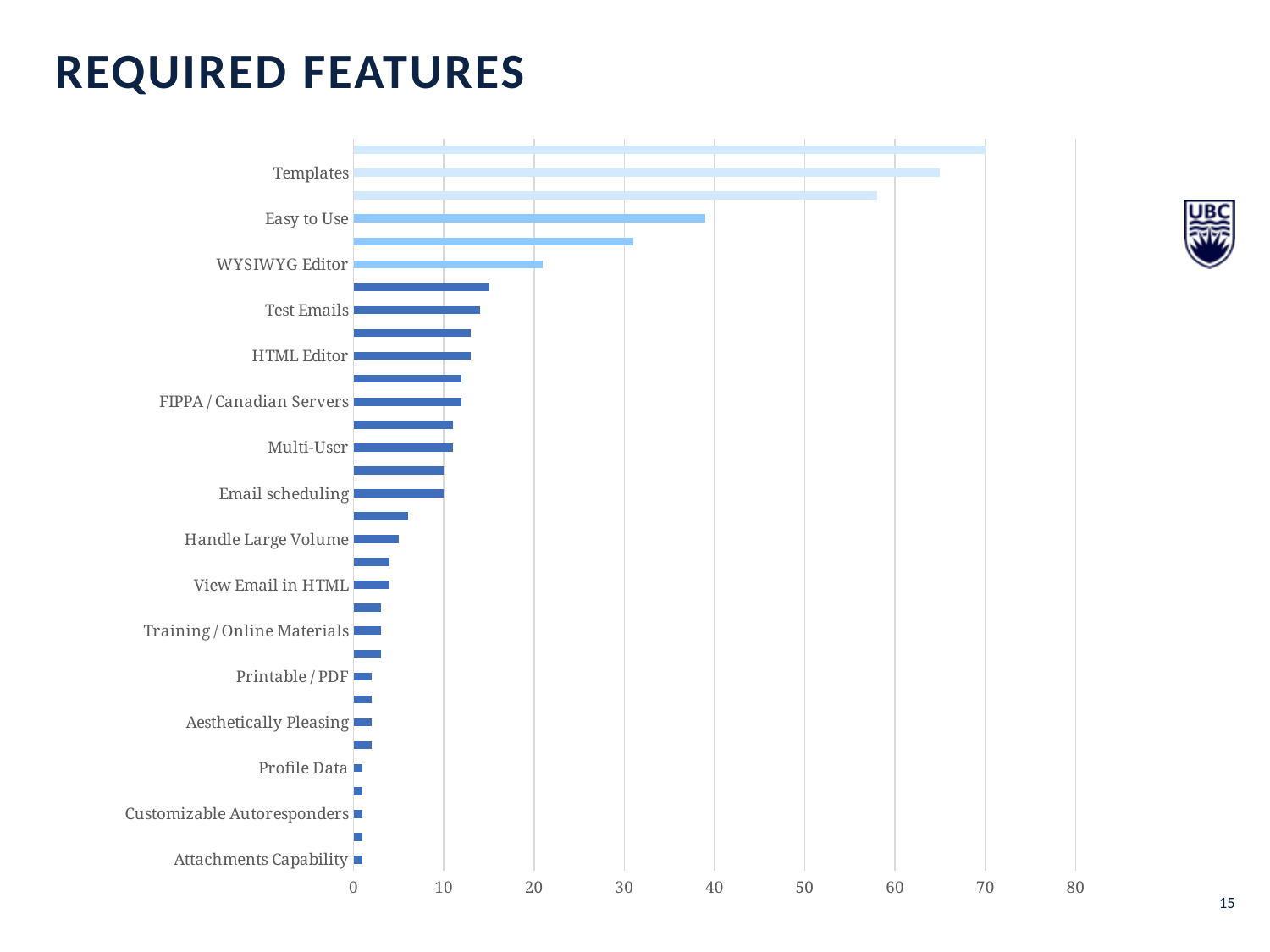
Is the value for Handle Large Volume greater or less than 10? less Which has a larger value, Easy to Use or WYSIWYG Editor? Easy to Use Is the value for Test Emails greater or less than 20? less Is the value for Templates greater or less than 60? greater Which labeled feature has the longest bar? Templates What kind of chart is shown on the slide? bar chart What is the highest value shown on the horizontal axis? 80 Which has a larger value, Templates or Multi-User? Templates Do the bar lengths increase or decrease going from the top of the chart to the bottom? decrease What is the title of the slide containing the chart? REQUIRED FEATURES